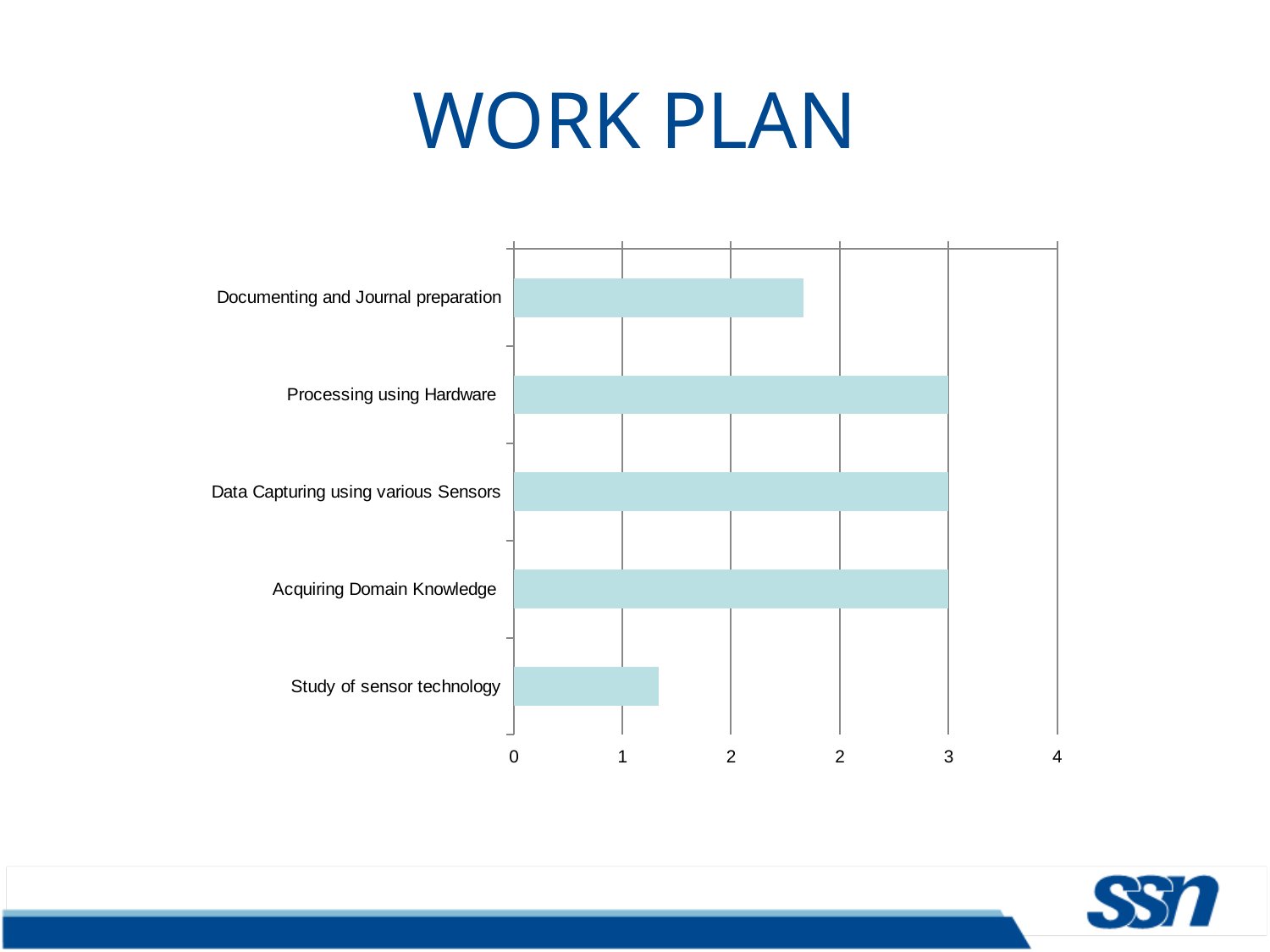
Is the value for Documenting and Journal preparation greater or less than 3? less What is the title of the slide containing the chart? WORK PLAN Is the value for Processing using Hardware greater or less than 4? less Which category has the lowest value in the chart? Study of sensor technology Which is larger, the value for Documenting and Journal preparation or the value for Study of sensor technology? Documenting and Journal preparation How many categories are plotted in the chart? 5 Which category is listed at the bottom of the chart's vertical axis? Study of sensor technology Which is larger, the value for Processing using Hardware or the value for Documenting and Journal preparation? Processing using Hardware Is the value for Acquiring Domain Knowledge greater or less than 1? greater What kind of chart is shown on the slide? bar chart